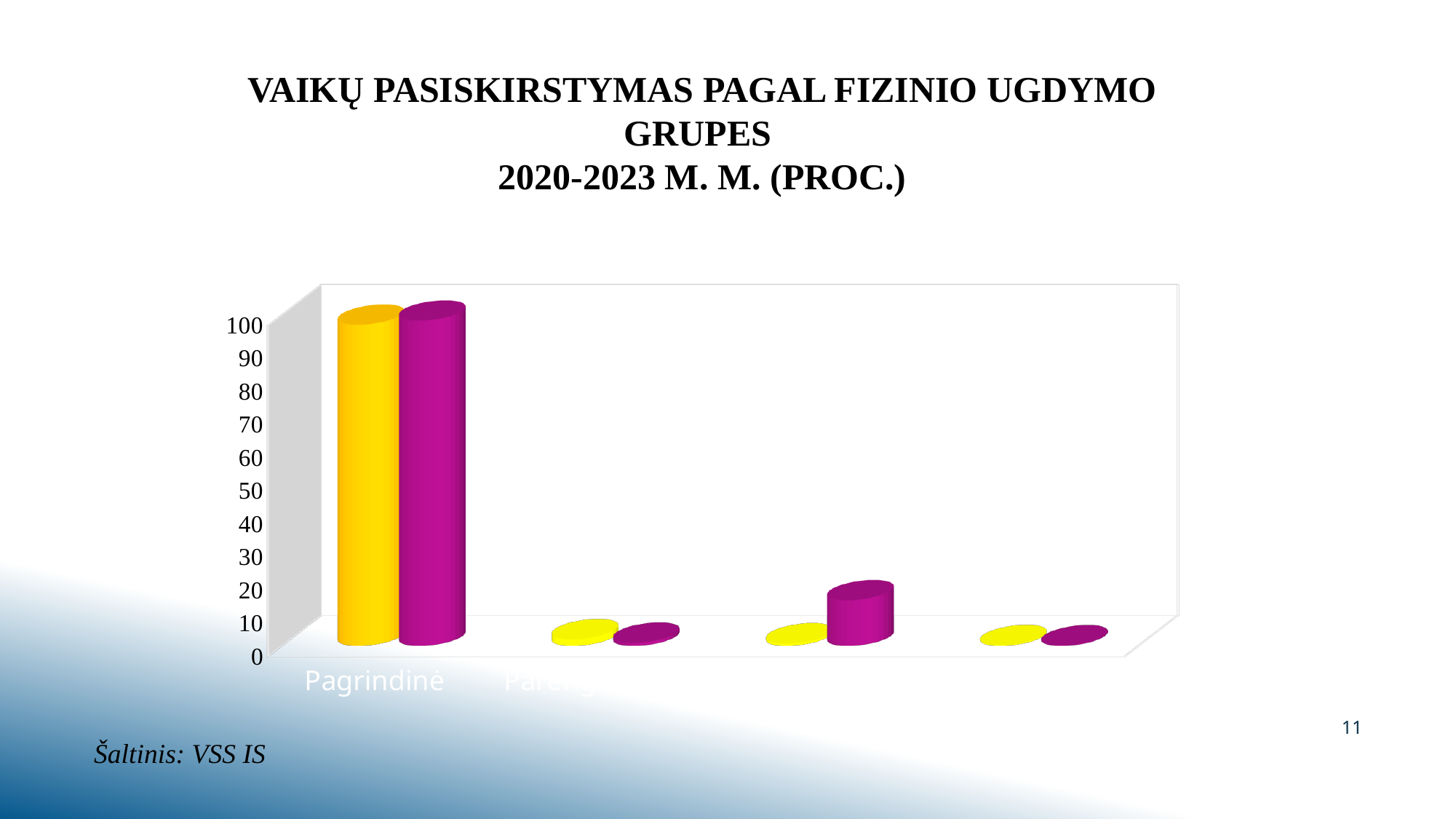
Is the value of the magenta bar in the third category greater or less than 30? less Is the value of the yellow bar in the third category greater or less than 10? less Which is larger: the magenta bar for Pagrindinė or the magenta bar in the third category? the magenta bar for Pagrindinė How many data series (bar colours) are plotted on the chart? 2 Is the value of the yellow bar for Pagrindinė greater or less than 90? greater What is the highest value shown on the vertical axis of the chart? 100 What kind of chart is shown on the slide? bar chart Which category has the highest values on the chart? Pagrindinė What is the title of the chart on the slide? VAIKŲ PASISKIRSTYMAS PAGAL FIZINIO UGDYMO GRUPES 2020-2023 M. M. (PROC.) How many categories (groups of bars) are plotted on the chart? 4